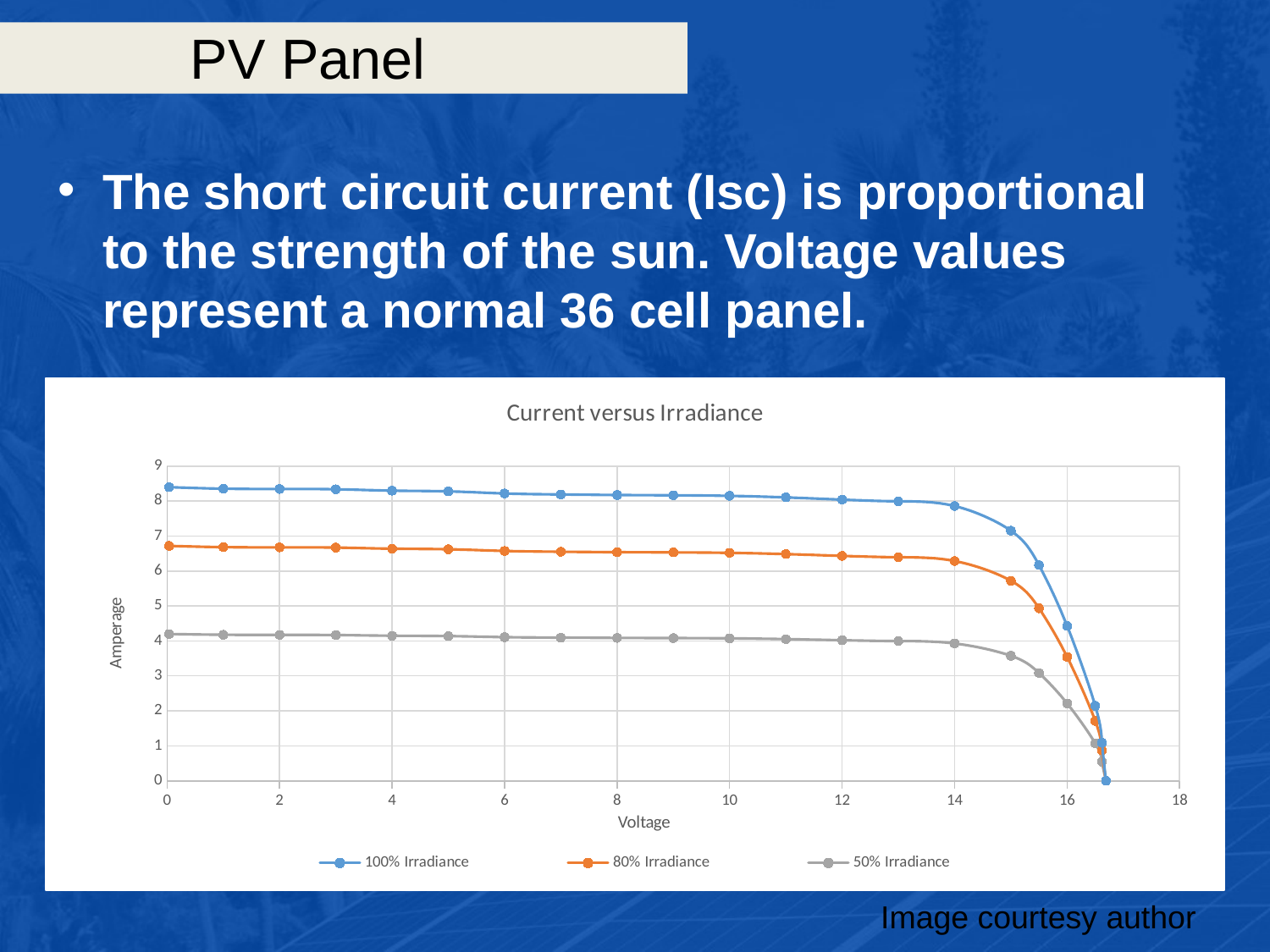
Is the amperage for 100% Irradiance at a voltage of 16 greater or less than 5? less What kind of chart is shown on the slide? line chart At a voltage of 10, which series has the larger amperage, 100% Irradiance or 80% Irradiance? 100% Irradiance Is the amperage for 50% Irradiance at a voltage of 0 greater or less than 5? less What is the title of the chart? Current versus Irradiance Which series has the highest amperage at a voltage of 0? 100% Irradiance Does the amperage for each series rise or fall as voltage increases along the x axis? fall Which series has the lowest amperage at a voltage of 10? 50% Irradiance How many series does the legend list? 3 What is the label of the vertical axis? Amperage Is the amperage for 80% Irradiance at a voltage of 0 greater or less than 6? greater